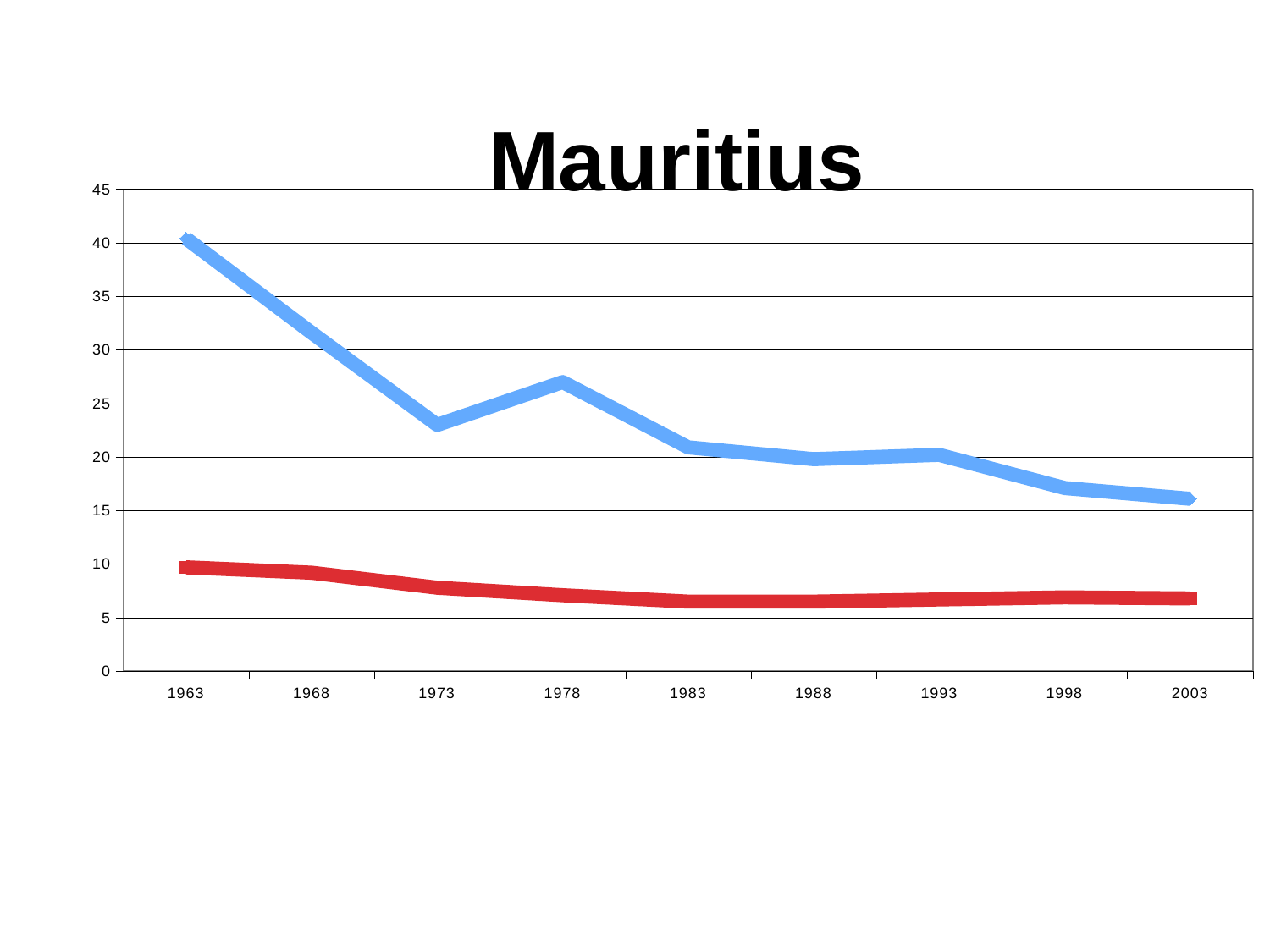
Is the value of the blue line in 1963 greater or less than 35? greater Is the value of the blue line in 1978 greater or less than 25? greater In which year is the red line at its highest? 1963 What is the title of the chart? Mauritius Does the blue line generally rise or fall from 1963 to 2003? fall How many lines are plotted on the chart? 2 Which line has the larger value in 1963, the blue line or the red line? the blue line How many years are plotted along the x axis? 9 In which year is the blue line at its highest? 1963 Is the value of the red line in 2003 greater or less than 10? less What kind of chart is shown on the slide? line chart